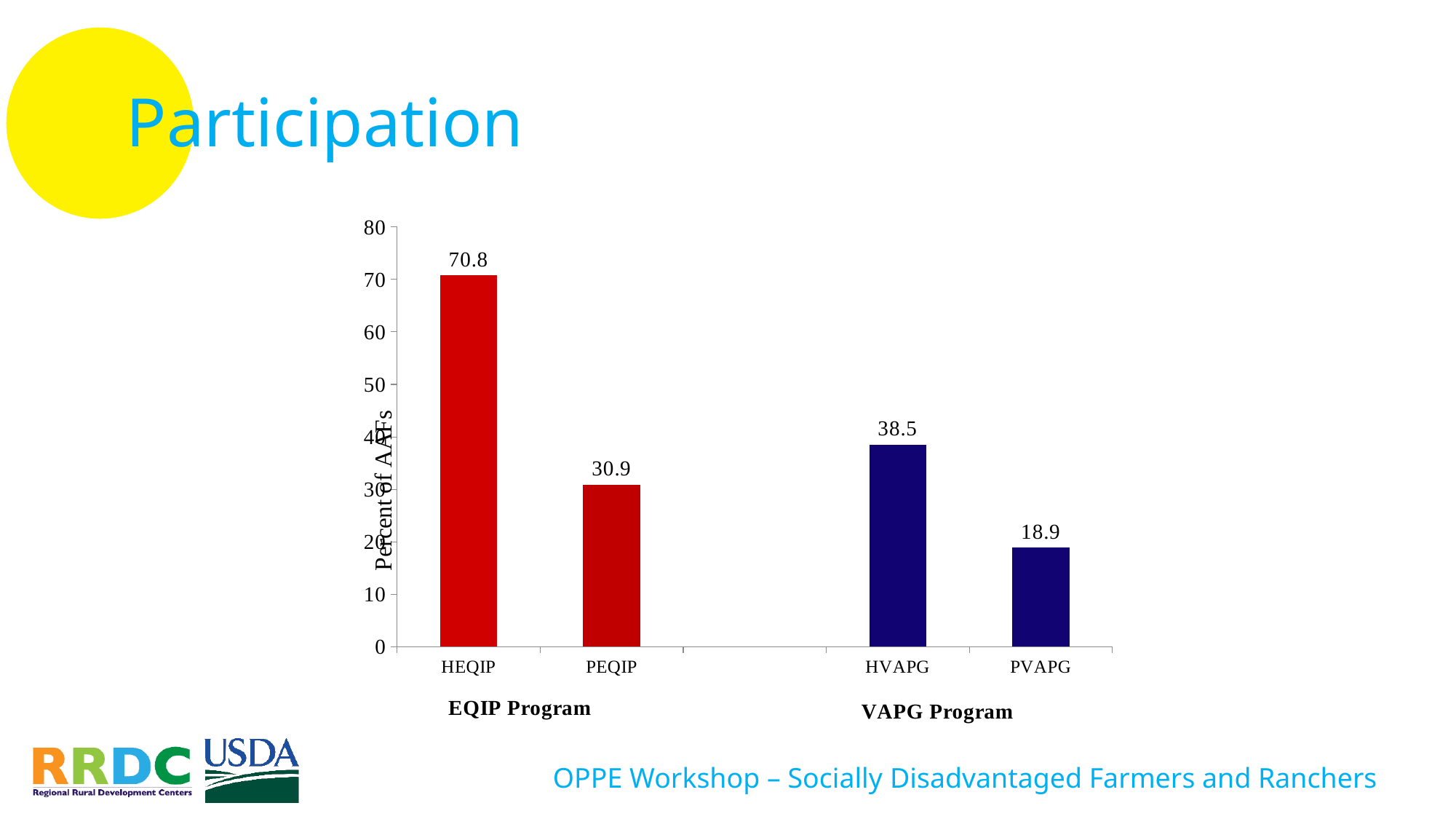
What kind of chart is shown on the slide? Bar chart What is the value for HEQIP? 70.8 What is the value for HVAPG? 38.5 How many bars are plotted in the chart? 4 What is the difference between the values for HEQIP and PEQIP? 39.9 Which is larger, the value for PEQIP or the value for HVAPG? HVAPG What is the label on the vertical axis of the chart? Percent of AAFs Which category has the lowest value? PVAPG Which category has the highest value? HEQIP What is the difference between the values for HVAPG and PVAPG? 19.6 What is the value for PEQIP? 30.9 What is the value for PVAPG? 18.9